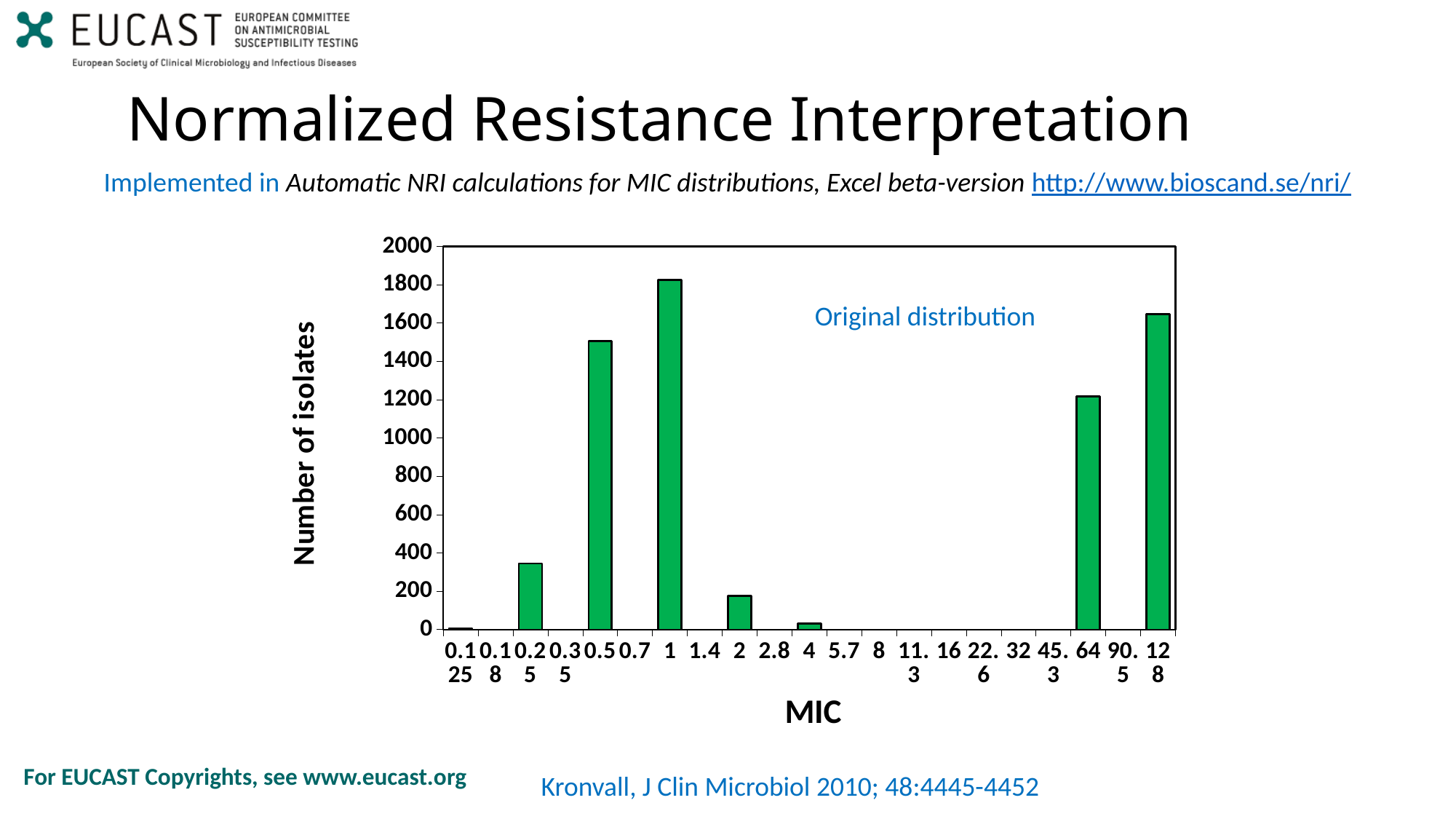
How many MIC categories are shown on the x axis? 21 Is the number of isolates at MIC 64 greater or less than 1400? less Is the number of isolates at MIC 0.5 greater or less than 1400? greater Is the number of isolates at MIC 0.25 greater or less than 400? less Which MIC category has the highest number of isolates? 1 What is the label of the y axis? Number of isolates Which has more isolates, MIC 128 or MIC 64? 128 What kind of chart is shown on the slide? bar chart Which has more isolates, MIC 0.5 or MIC 64? 0.5